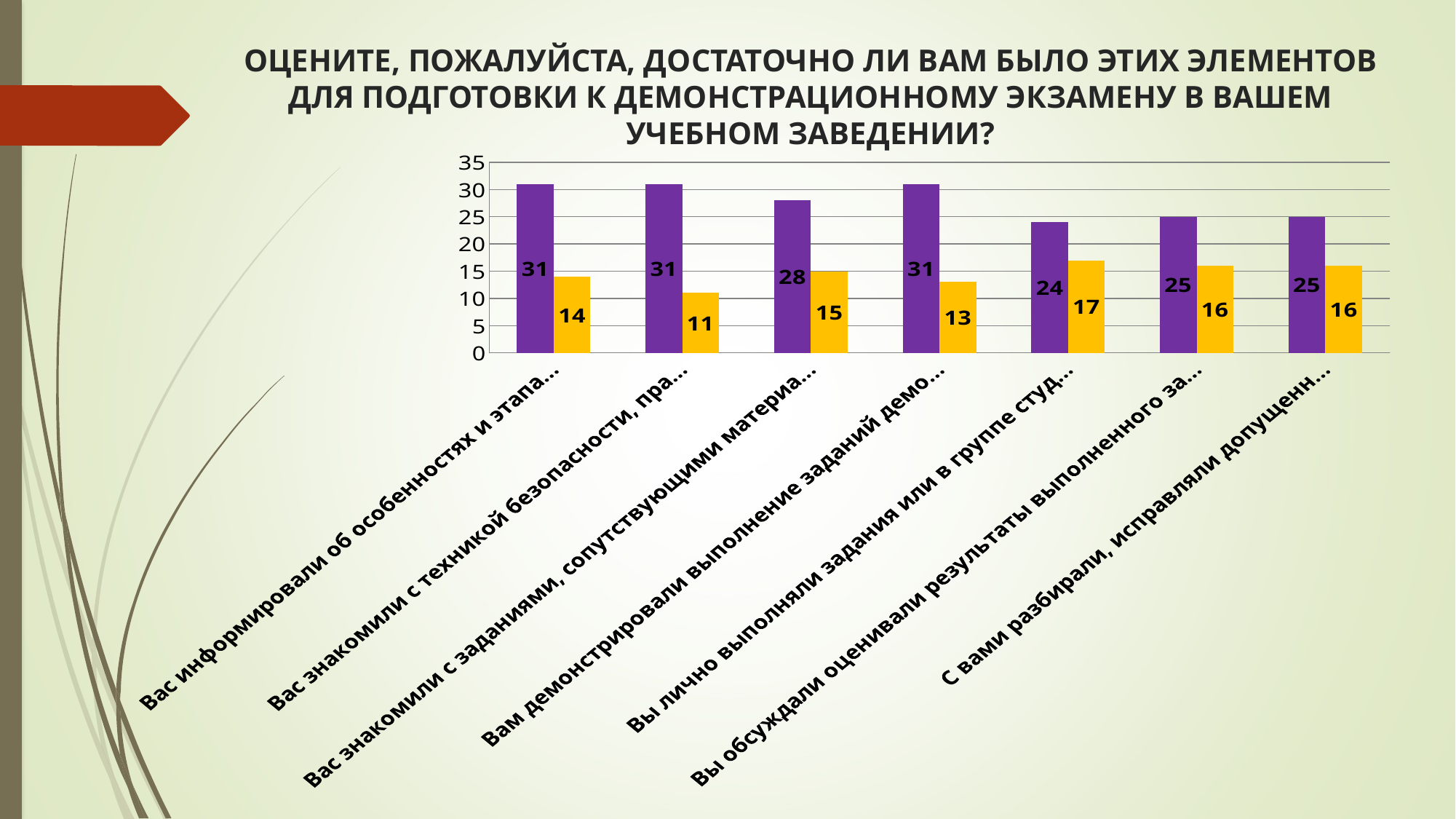
Which category has the highest yellow bar? Вы лично выполняли задания или в группе студ... What two colours are used for the bars in the chart? purple and yellow What kind of chart is shown on the slide? bar chart How many categories are shown on the x axis of the chart? 7 Which category has the lowest yellow bar? Вас знакомили с техникой безопасности, пра... What is the difference between the purple and yellow bars for the category beginning "Вас информировали об особенностях и этапа..."? 17 How many data series are plotted in the chart? 2 What is the value of the yellow bar for the category beginning "Вас знакомили с техникой безопасности, пра..."? 11 What is the value of the yellow bar for the category beginning "Вы лично выполняли задания или в группе студ..."? 17 Which category has the lowest purple bar? Вы лично выполняли задания или в группе студ... What is the value of the purple bar for the category beginning "Вас знакомили с заданиями, сопутствующими материа..."? 28 Which is larger: the purple bar for "Вам демонстрировали выполнение заданий демо..." or the purple bar for "С вами разбирали, исправляли допущенн..."? Вам демонстрировали выполнение заданий демо...